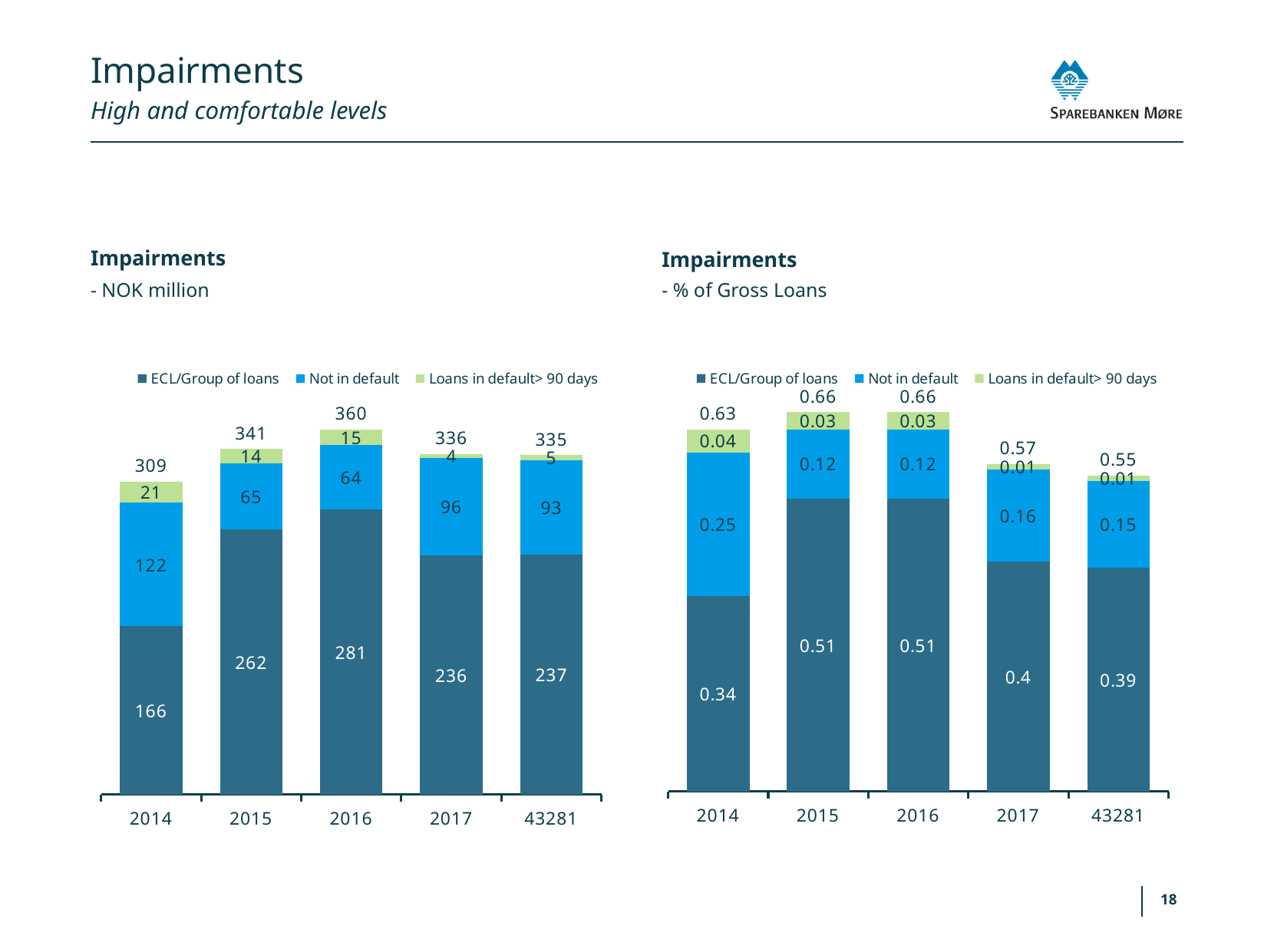
What kind of chart is the right chart (Impairments - % of Gross Loans)? Stacked bar chart In the left chart (Impairments - NOK million), which year has the highest total impairments? 2016 In the right chart (Impairments - % of Gross Loans), which category has the lowest total? 43281 In the left chart (Impairments - NOK million), what is the total of the stacked bar for 2014? 309 In the left chart (Impairments - NOK million), what is the difference between the ECL/Group of loans values for 2015 and 2014? 96 In the left chart (Impairments - NOK million), which category has the lowest Loans in default> 90 days value? 2017 In the right chart (Impairments - % of Gross Loans), what is the Not in default value for 2014? 0.25 How many series does the legend of the left chart (Impairments - NOK million) list? 3 In the right chart (Impairments - % of Gross Loans), what is the total of the stacked bar for 2017? 0.57 In the left chart (Impairments - NOK million), what is the Not in default value for 2017? 96 In the left chart (Impairments - NOK million), what is the ECL/Group of loans value for 2016? 281 In the right chart (Impairments - % of Gross Loans), which is larger, the ECL/Group of loans value for 2015 or for 2014? 2015